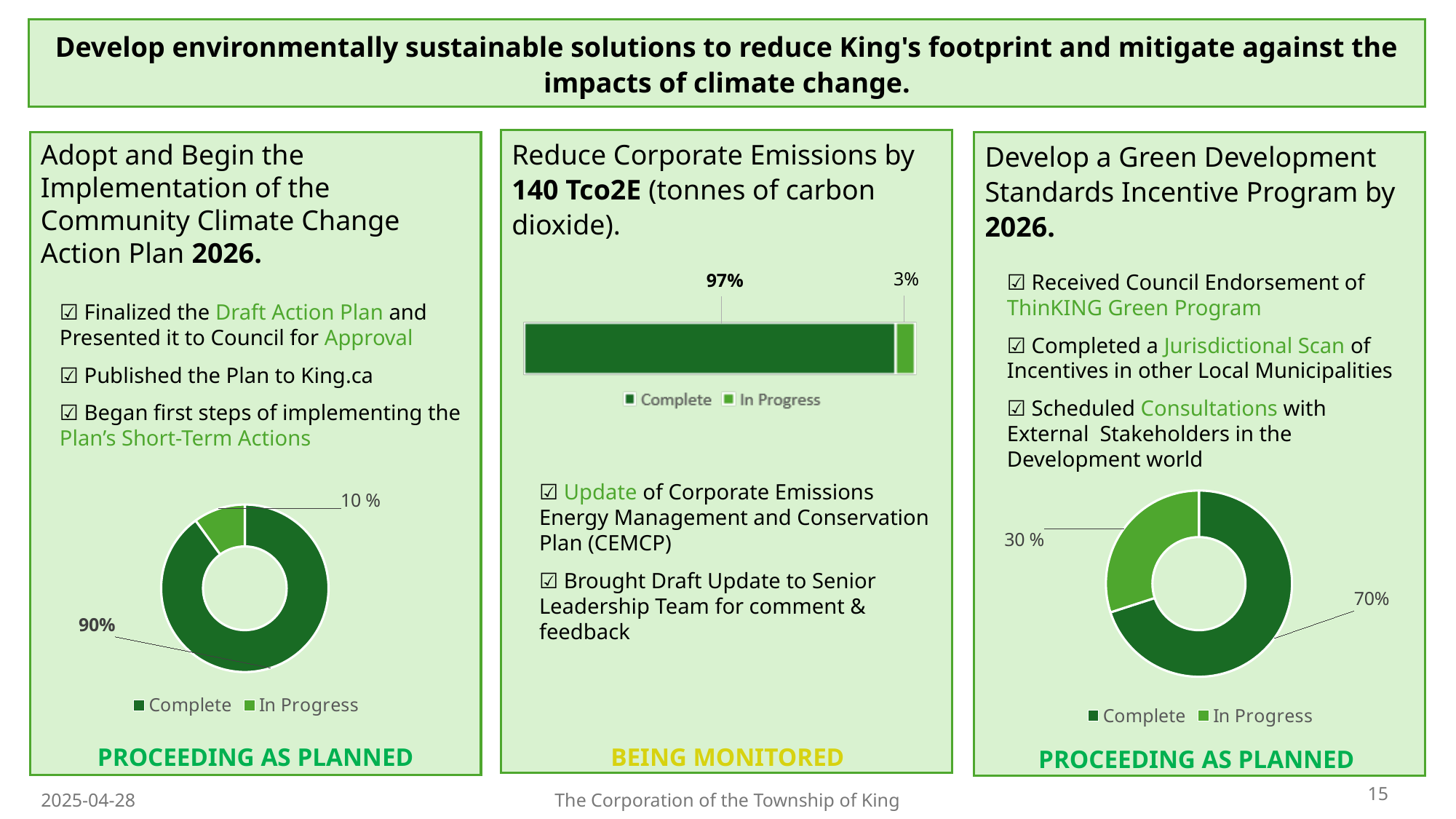
How many series does the legend of the right chart list? 2 In the right chart, what share is labelled Complete? 70% What kind of chart is shown in the left panel? Donut chart In the middle chart, what is the difference between the Complete and In Progress values? 94% What kind of chart is shown in the middle panel? Bar chart In the right chart, what share is labelled In Progress? 30 % In the left chart, what share is labelled Complete? 90% In the right chart, which segment is larger, Complete or In Progress? Complete In the middle chart, what is the value for In Progress? 3% In the left chart, what share is labelled In Progress? 10 % In the left chart, what is the difference between the Complete and In Progress shares? 80% In the middle chart, what is the value for Complete? 97%